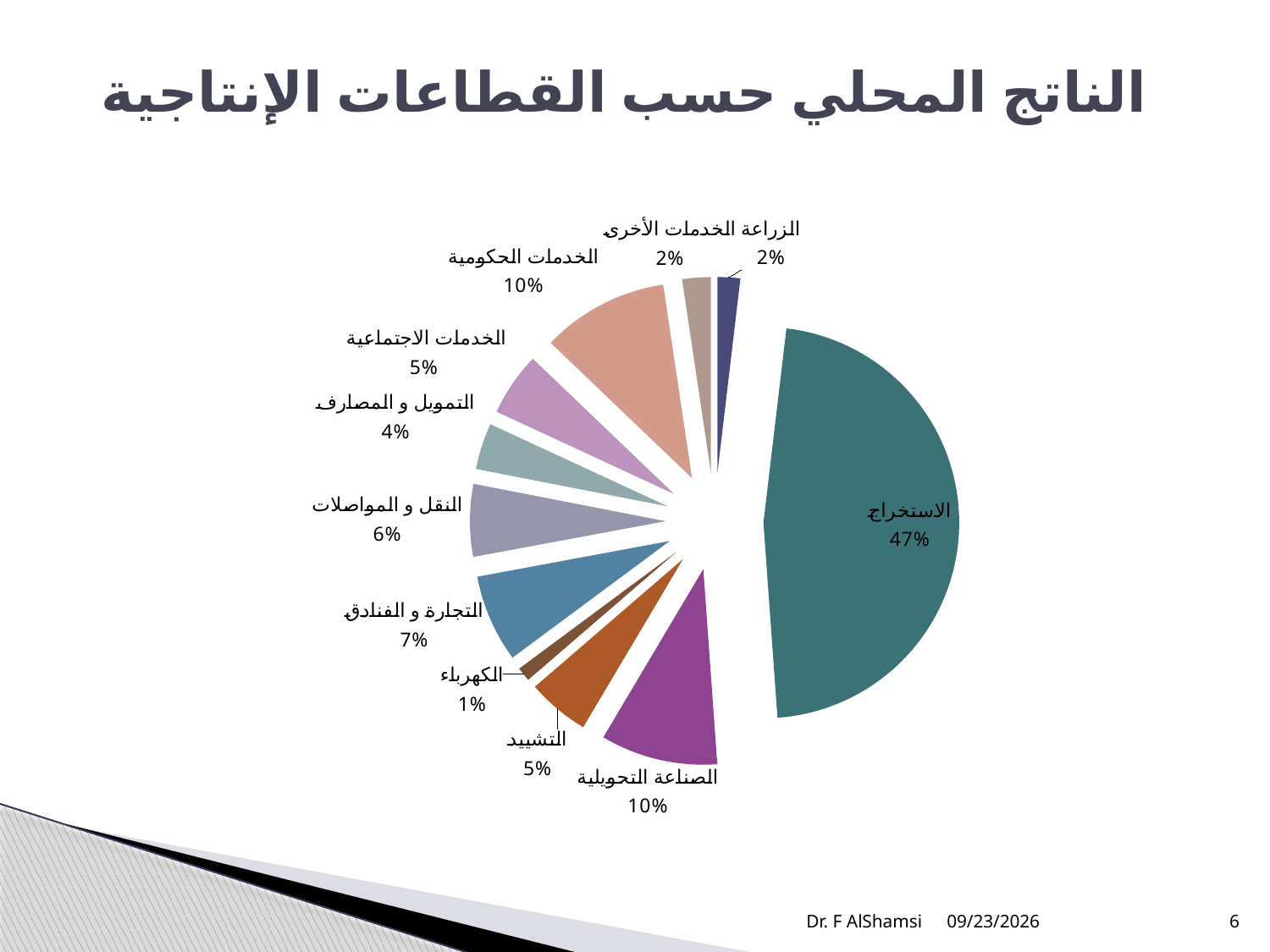
Which is larger, التجارة و الفنادق or التشييد? التجارة و الفنادق Which sector has the largest slice of the pie? الاستخراج What is the value shown for الصناعة التحويلية? 10% What kind of chart is shown on the slide? pie chart What is the title of the slide? الناتج المحلي حسب القطاعات الإنتاجية What share of the pie does الاستخراج hold? 47% What is the value shown for الكهرباء? 1% Which sector has the smallest slice of the pie? الكهرباء What is the difference between the values for الاستخراج and الخدمات الحكومية? 37% What is the value shown for النقل و المواصلات? 6% How many slices does the pie chart have? 11 What is the value shown for التمويل و المصارف? 4%